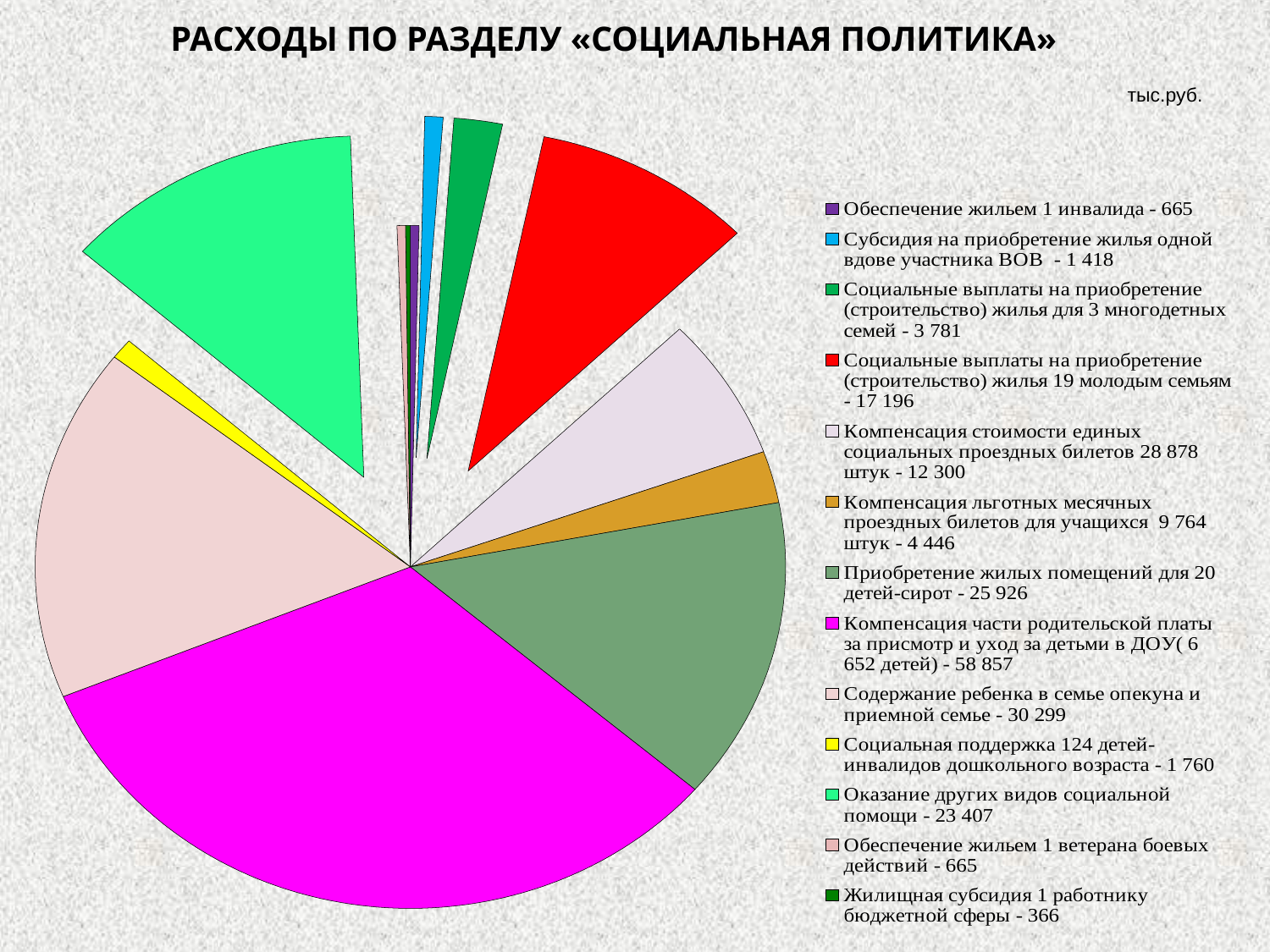
What is the difference between «Компенсация части родительской платы за присмотр и уход за детьми в ДОУ» (58 857) and «Содержание ребенка в семье опекуна и приемной семье» (30 299)? 28 558 In what units are the values on the chart given? тыс.руб. What is the title of the slide? РАСХОДЫ ПО РАЗДЕЛУ «СОЦИАЛЬНАЯ ПОЛИТИКА» What kind of chart is shown on the slide? pie chart What is the value for «Социальные выплаты на приобретение (строительство) жилья 19 молодым семьям»? 17 196 What is the value for «Жилищная субсидия 1 работнику бюджетной сферы»? 366 What is the value for «Компенсация части родительской платы за присмотр и уход за детьми в ДОУ (6 652 детей)»? 58 857 Which category has the smallest value in the pie chart? Жилищная субсидия 1 работнику бюджетной сферы Which category has the largest value in the pie chart? Компенсация части родительской платы за присмотр и уход за детьми в ДОУ (6 652 детей) How many categories does the pie chart have? 13 What is the value for «Приобретение жилых помещений для 20 детей-сирот»? 25 926 Which is larger: «Приобретение жилых помещений для 20 детей-сирот» or «Оказание других видов социальной помощи»? Приобретение жилых помещений для 20 детей-сирот